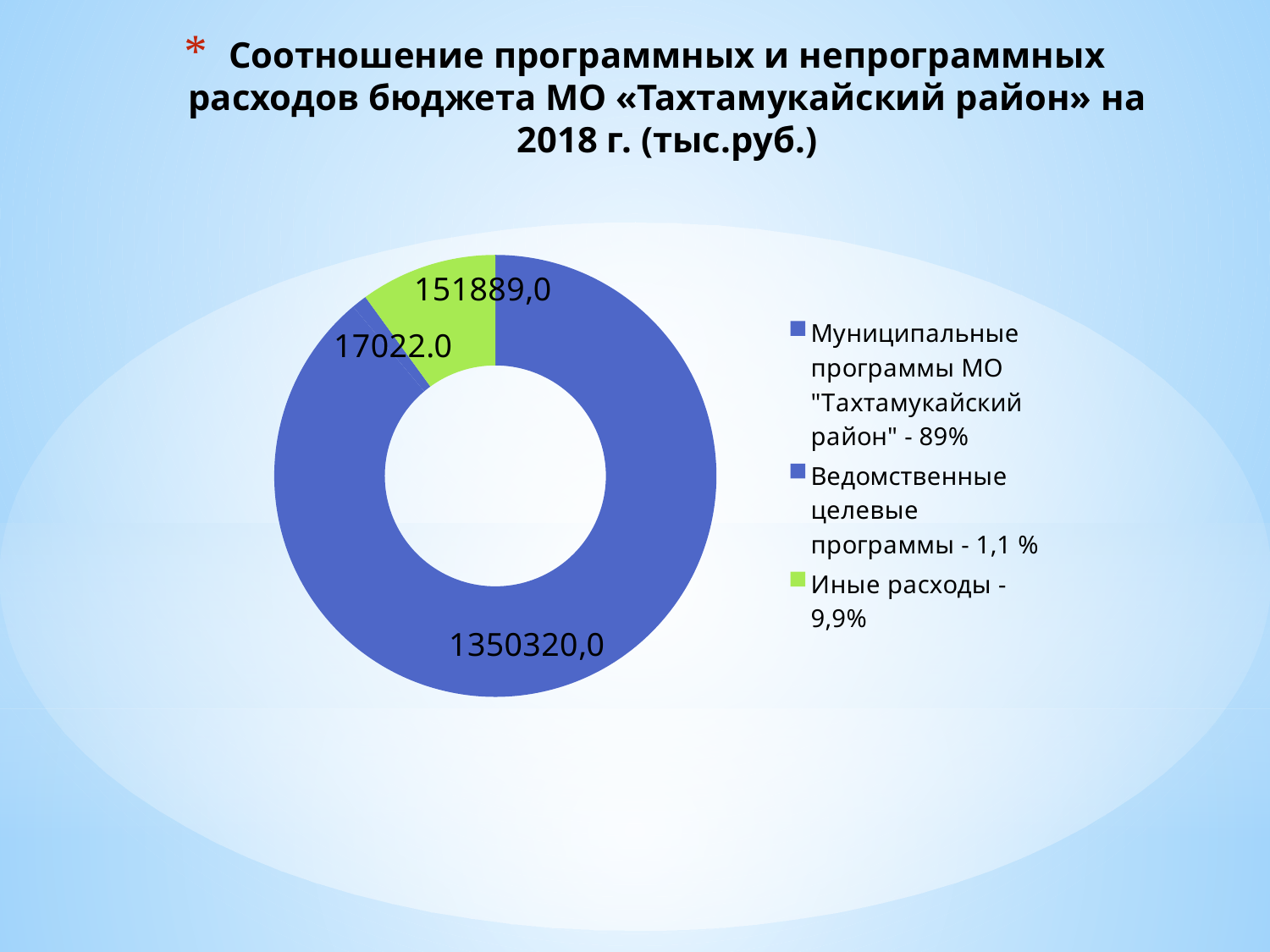
What share of the total do Муниципальные программы МО "Тахтамукайский район" represent, according to the legend? 89% Which is larger: Иные расходы or Ведомственные целевые программы? Иные расходы Which category has the smallest value? Ведомственные целевые программы What is the value for Муниципальные программы МО "Тахтамукайский район"? 1350320,0 What is the value for Иные расходы? 151889,0 What is the difference between the values for Иные расходы and Ведомственные целевые программы? 134867,0 What is the value for Ведомственные целевые программы? 17022.0 What kind of chart is shown on the slide? doughnut (pie) chart What colour is the slice for Иные расходы? green How many categories does the legend list? 3 What share of the total do Иные расходы represent, according to the legend? 9,9% Which category has the largest value? Муниципальные программы МО "Тахтамукайский район"